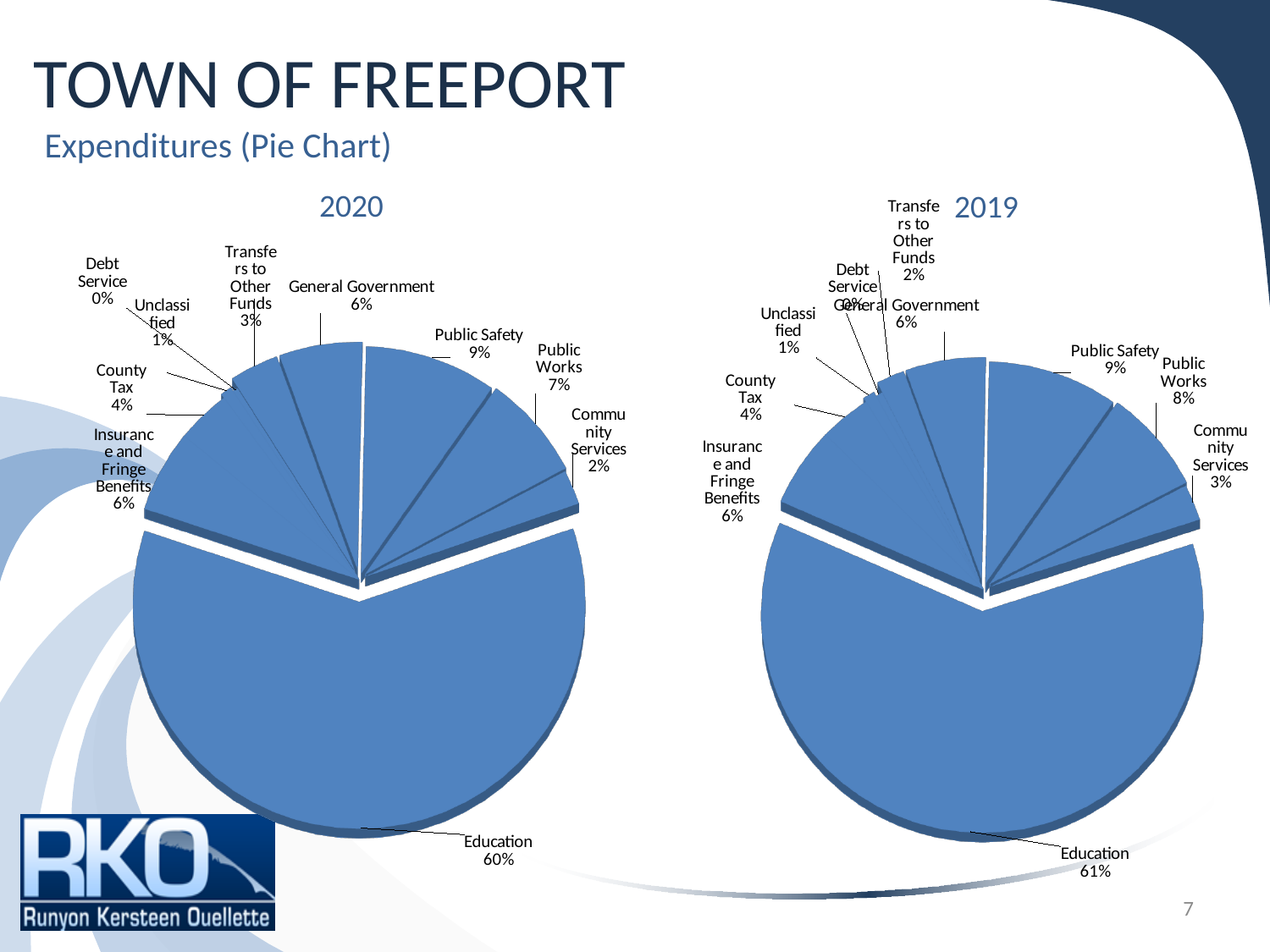
In the 2020 pie chart, which category has the largest share? Education In the 2020 pie chart, what share of expenditures is Education? 60% In the 2019 pie chart, what share of expenditures is Education? 61% In the 2020 pie chart, what percentage is shown for Public Safety? 9% How many categories are shown in the 2019 pie chart? 10 In the 2020 pie chart, what is the difference in percentage points between Public Safety and Public Works? 2 What type of chart is used on this slide? Pie chart In the 2020 pie chart, what percentage is shown for Community Services? 2% In the 2019 pie chart, what percentage is shown for Public Works? 8% In the 2020 pie chart, which is larger: County Tax or Insurance and Fringe Benefits? Insurance and Fringe Benefits In the 2019 pie chart, what percentage is shown for Transfers to Other Funds? 2% In the 2019 pie chart, which category has the smallest share? Debt Service